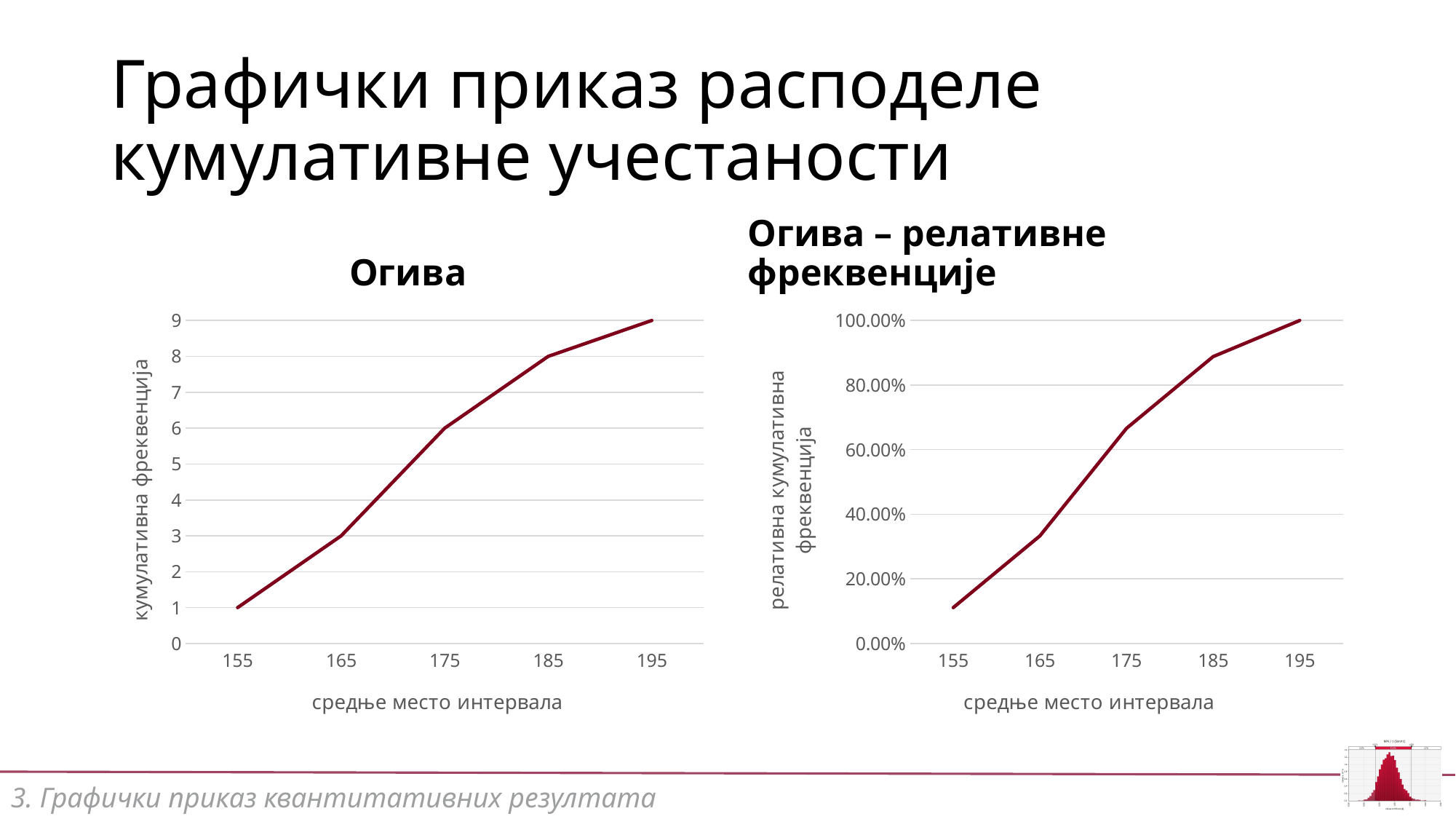
On the chart titled "Огива", what is the cumulative frequency at 195? 9 On the chart titled "Огива", what is the cumulative frequency at 155? 1 How many data points are plotted on the chart titled "Огива"? 5 On the chart titled "Огива – релативне фреквенције", is the value at 185 greater or less than 80.00%? greater On the chart titled "Огива", do the values rise or fall as the x axis goes from 155 to 195? rise On the chart titled "Огива", which x-axis category has the lowest value? 155 On the chart titled "Огива", what is the difference between the values at 185 and 165? 5 On the chart titled "Огива – релативне фреквенције", what is the value at 195? 100.00% What kind of chart is the chart titled "Огива"? line chart On the chart titled "Огива – релативне фреквенције", is the value at 165 greater or less than 40.00%? less What is the x-axis label on the chart titled "Огива"? средње место интервала On the chart titled "Огива", what is the cumulative frequency at 175? 6